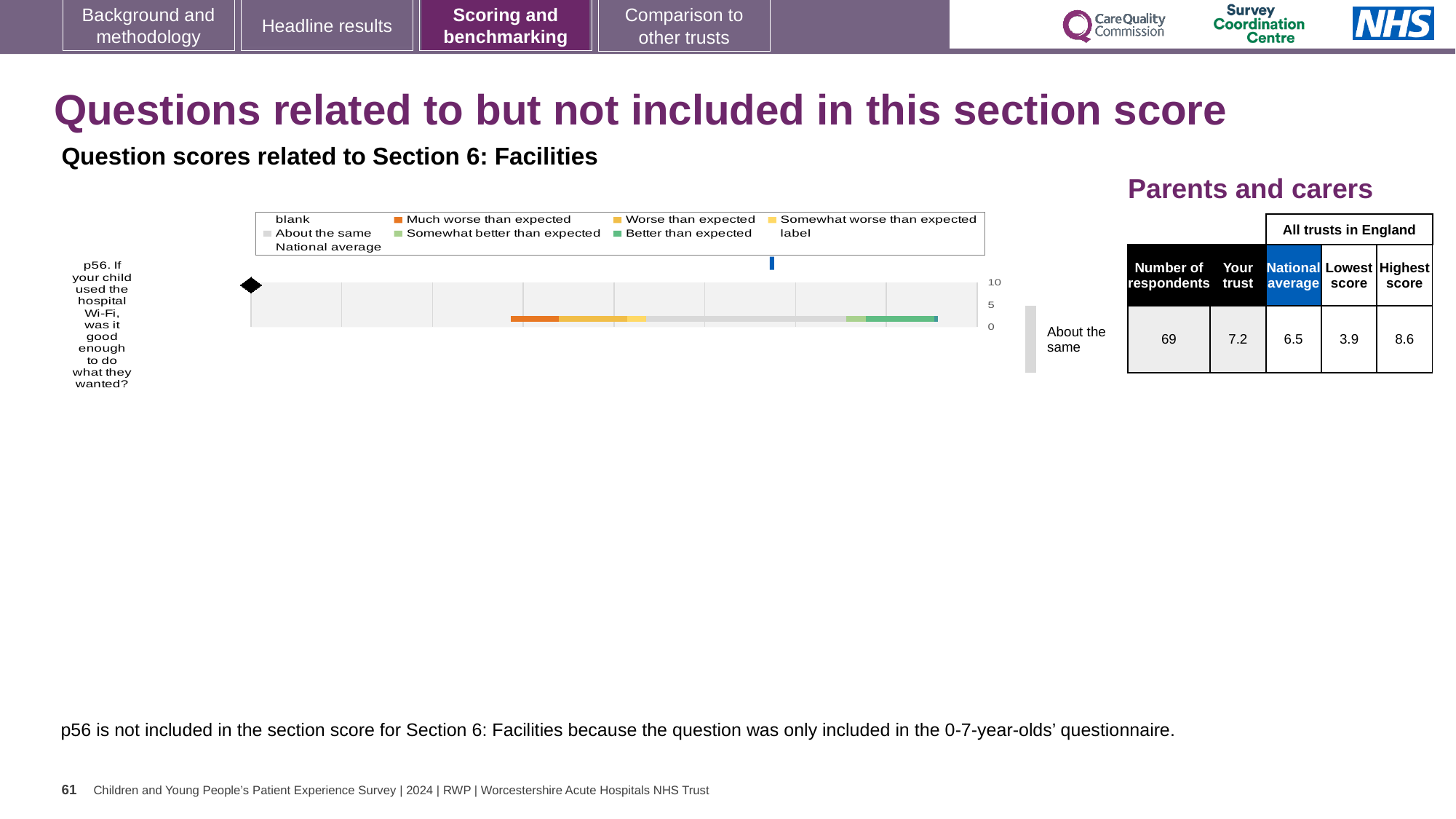
Which is larger for p56, the 'Your trust' score or the national average? Your trust What kind of chart is used to show the p56 question score? Bar chart What is the lowest score among all trusts in England for p56? 3.9 Which benchmark category is the trust's p56 result placed in? About the same What is the national average score for p56? 6.5 Which question is plotted on the chart? p56. If your child used the hospital Wi-Fi, was it good enough to do what they wanted? What is the highest value shown on the chart's score axis? 10 How many survey questions are plotted on the chart? 1 What is the 'Your trust' score for p56? 7.2 What is the difference between the 'Your trust' score and the national average for p56? 0.7 How many respondents answered p56? 69 What is the highest score among all trusts in England for p56? 8.6